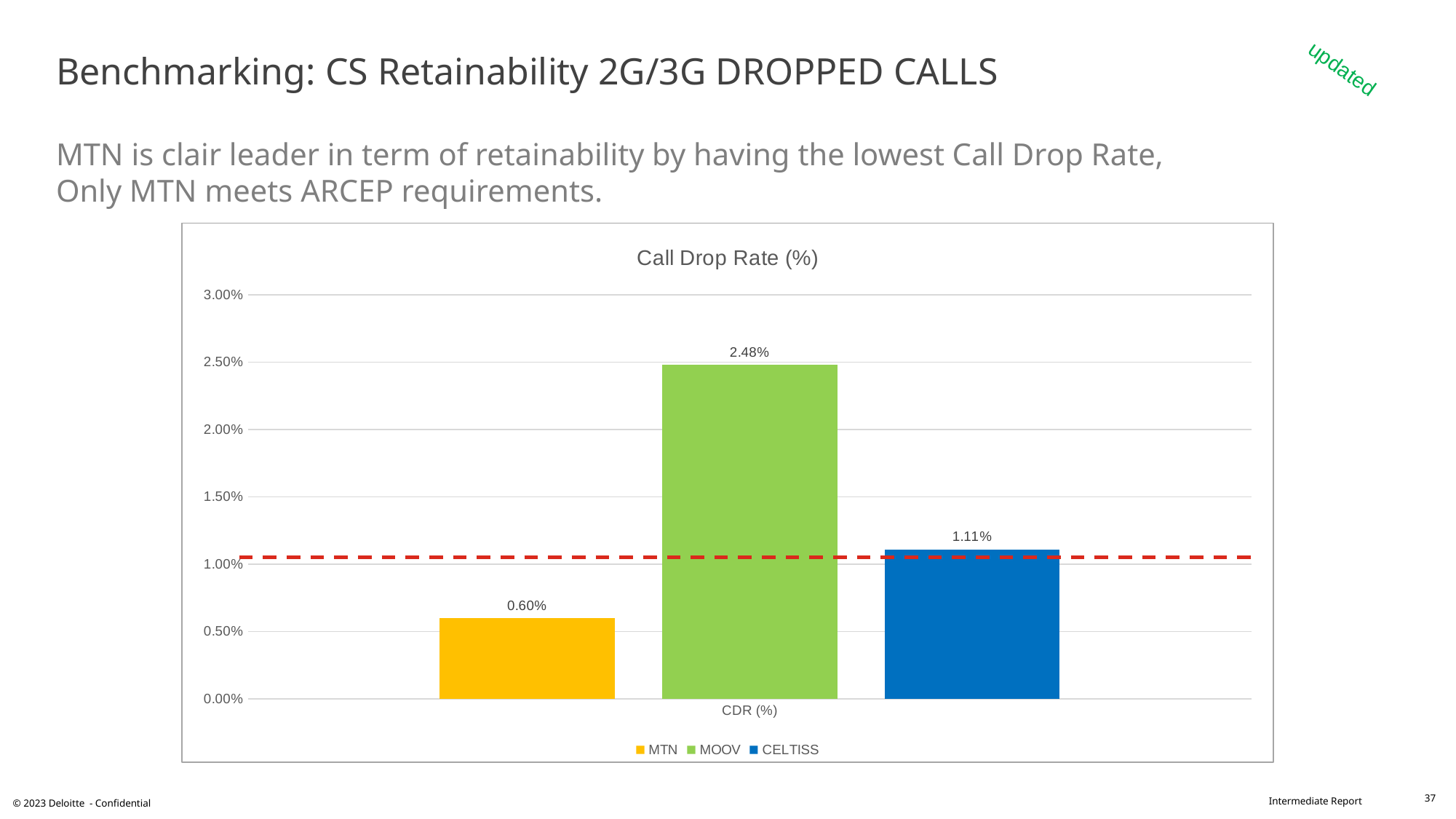
Is the Call Drop Rate for MOOV greater or less than 2.00%? greater What is the difference between the Call Drop Rate of MOOV and MTN? 1.88% Which operator has the lowest Call Drop Rate? MTN What is the Call Drop Rate for MTN? 0.60% Which has a higher Call Drop Rate, CELTISS or MTN? CELTISS What is the Call Drop Rate for MOOV? 2.48% Which operator has the highest Call Drop Rate? MOOV What kind of chart is shown on the slide? Bar chart What is the title of the chart? Call Drop Rate (%) How many series does the legend list? 3 What is the Call Drop Rate for CELTISS? 1.11% What is the difference between the Call Drop Rate of CELTISS and MTN? 0.51%